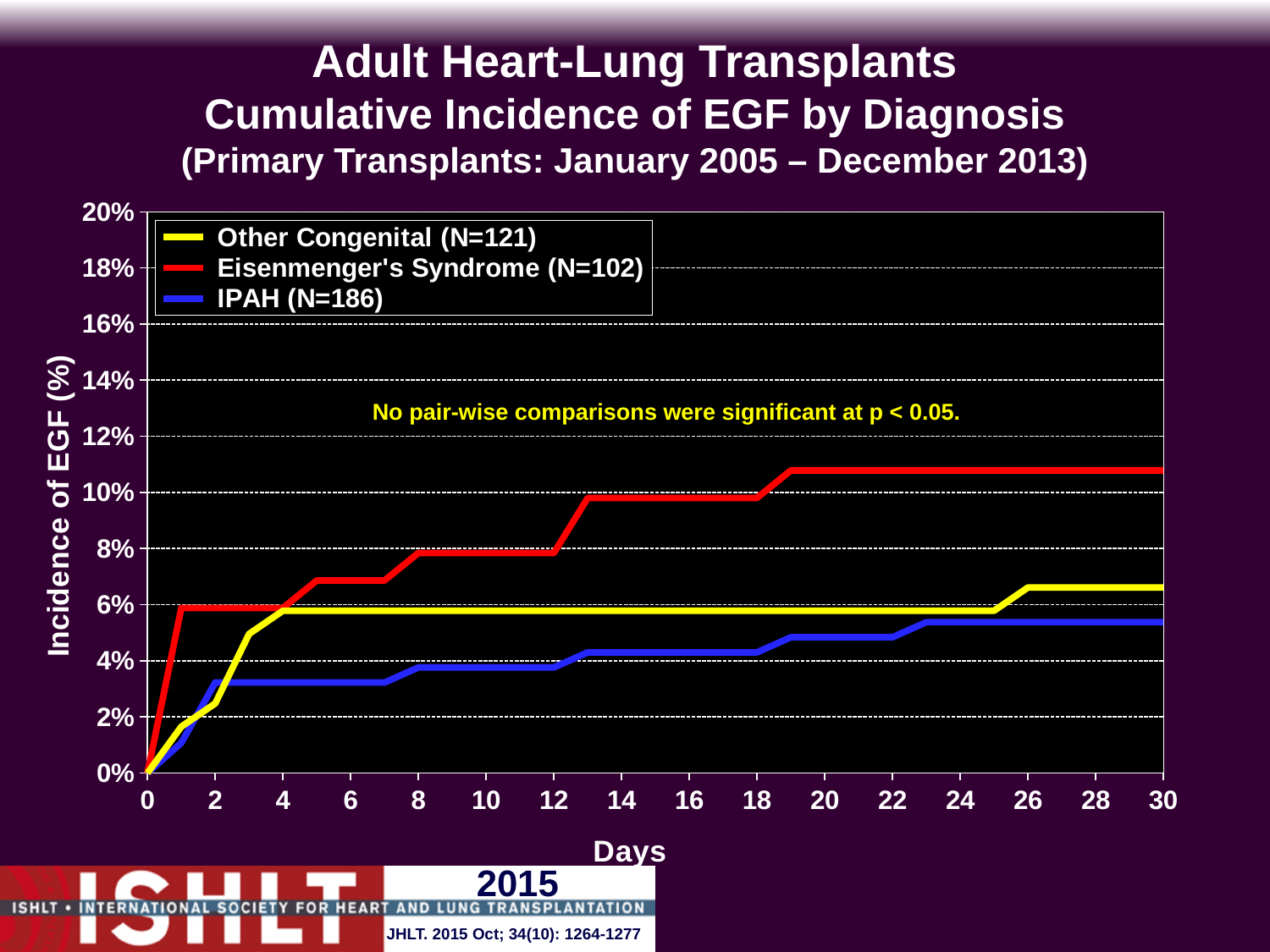
Is the value for IPAH at day 30 greater or less than 6%? less Is the value for Other Congenital at day 30 greater or less than 6%? greater Is the value for Eisenmenger's Syndrome at day 2 greater or less than 4%? greater What does the note printed inside the chart say about pair-wise comparisons? No pair-wise comparisons were significant at p < 0.05. At day 10, which is larger: the value for Eisenmenger's Syndrome or the value for IPAH? Eisenmenger's Syndrome What is the N value shown in the legend for IPAH? 186 Which diagnosis group has the lowest cumulative incidence of EGF at day 30? IPAH What kind of chart is shown on the slide? line chart Do the cumulative incidence values rise or fall as the number of days increases? rise How many series does the legend list? 3 Which diagnosis group has the highest cumulative incidence of EGF at day 30? Eisenmenger's Syndrome